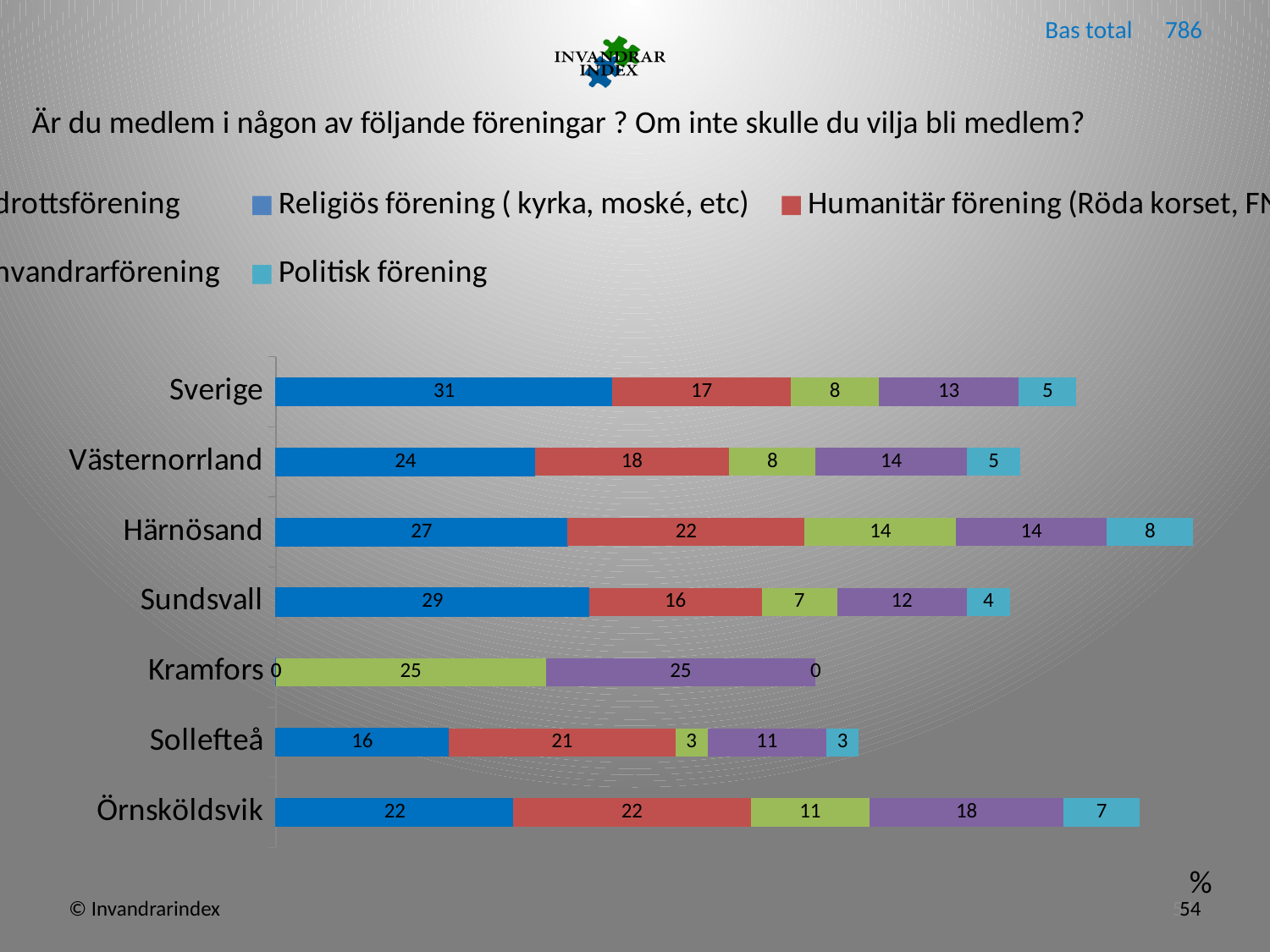
What is the difference between the Politisk förening values for Härnösand and Sollefteå? 5 What is the value of the first (dark blue) segment for Sollefteå? 16 What is the value for Politisk förening (the last, light blue segment) for Sundsvall? 4 What is the 'Bas total' shown at the top right of the slide? 786 What is the total of the stacked bar for Sverige? 74 What is the total of the stacked bar for Härnösand? 85 Which region has the highest value for Politisk förening (the last, light blue segment)? Härnösand What is the value for Politisk förening (the last, light blue segment) for Härnösand? 8 What kind of chart is shown on the slide? Stacked bar chart How many regions (categories) are shown on the chart? 7 How many series does the legend list? 5 Which has the larger first (dark blue) segment, Sverige or Västernorrland? Sverige